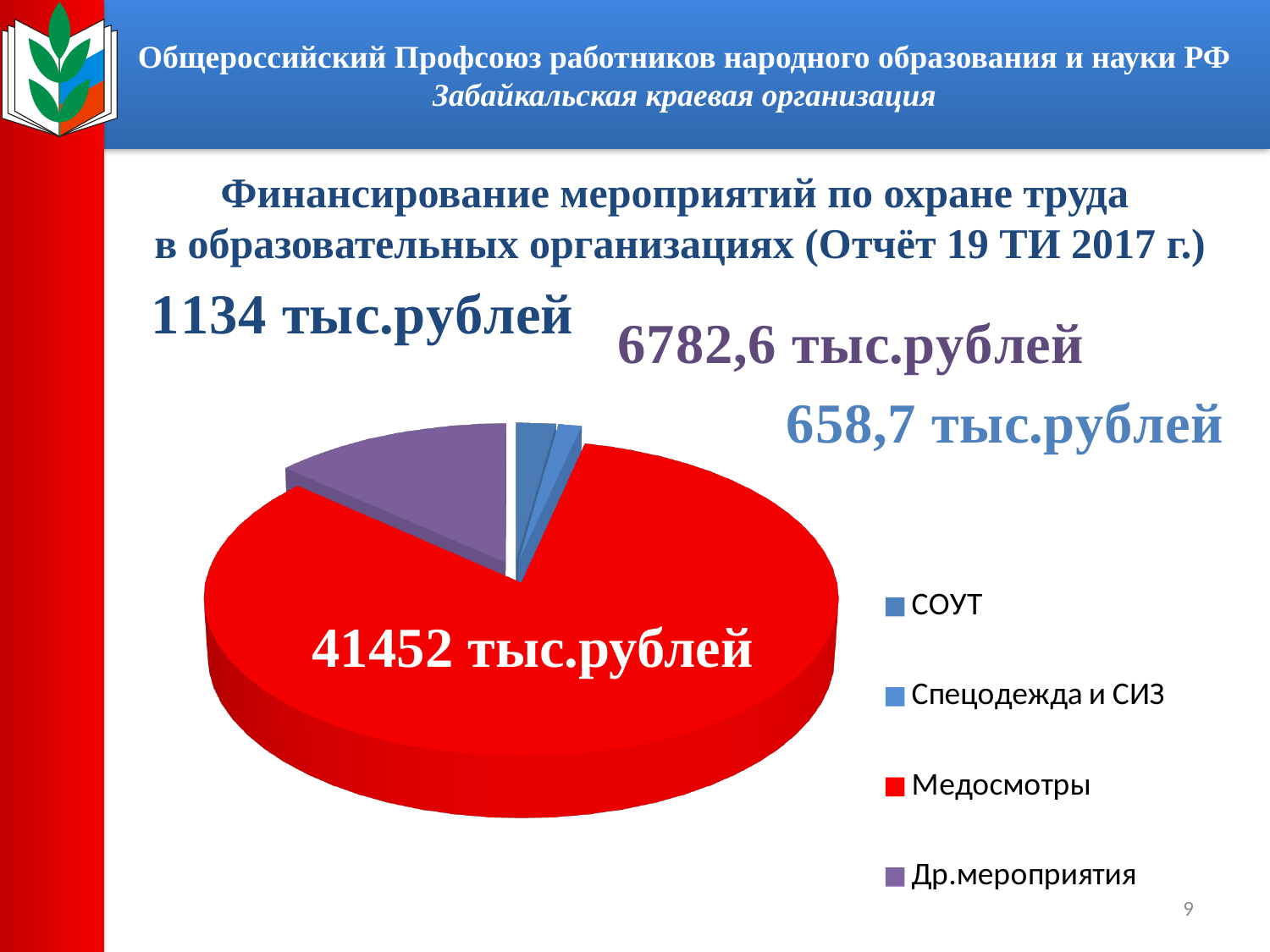
What is the difference between the value for Медосмотры and the value for Др.мероприятия? 34669,4 тыс.рублей What kind of chart is shown on the slide? pie chart Which category has the largest slice of the pie? Медосмотры How many entries does the legend of the pie chart list? 4 What is the value shown for Спецодежда и СИЗ? 658,7 тыс.рублей How many slices does the pie chart have? 4 What colour is the Медосмотры slice in the pie chart? red Which is larger, the value for Др.мероприятия or the value for СОУТ? Др.мероприятия What is the value shown for Др.мероприятия? 6782,6 тыс.рублей Which category has the smallest slice of the pie? Спецодежда и СИЗ What is the value shown for СОУТ? 1134 тыс.рублей What is the value shown for Медосмотры? 41452 тыс.рублей